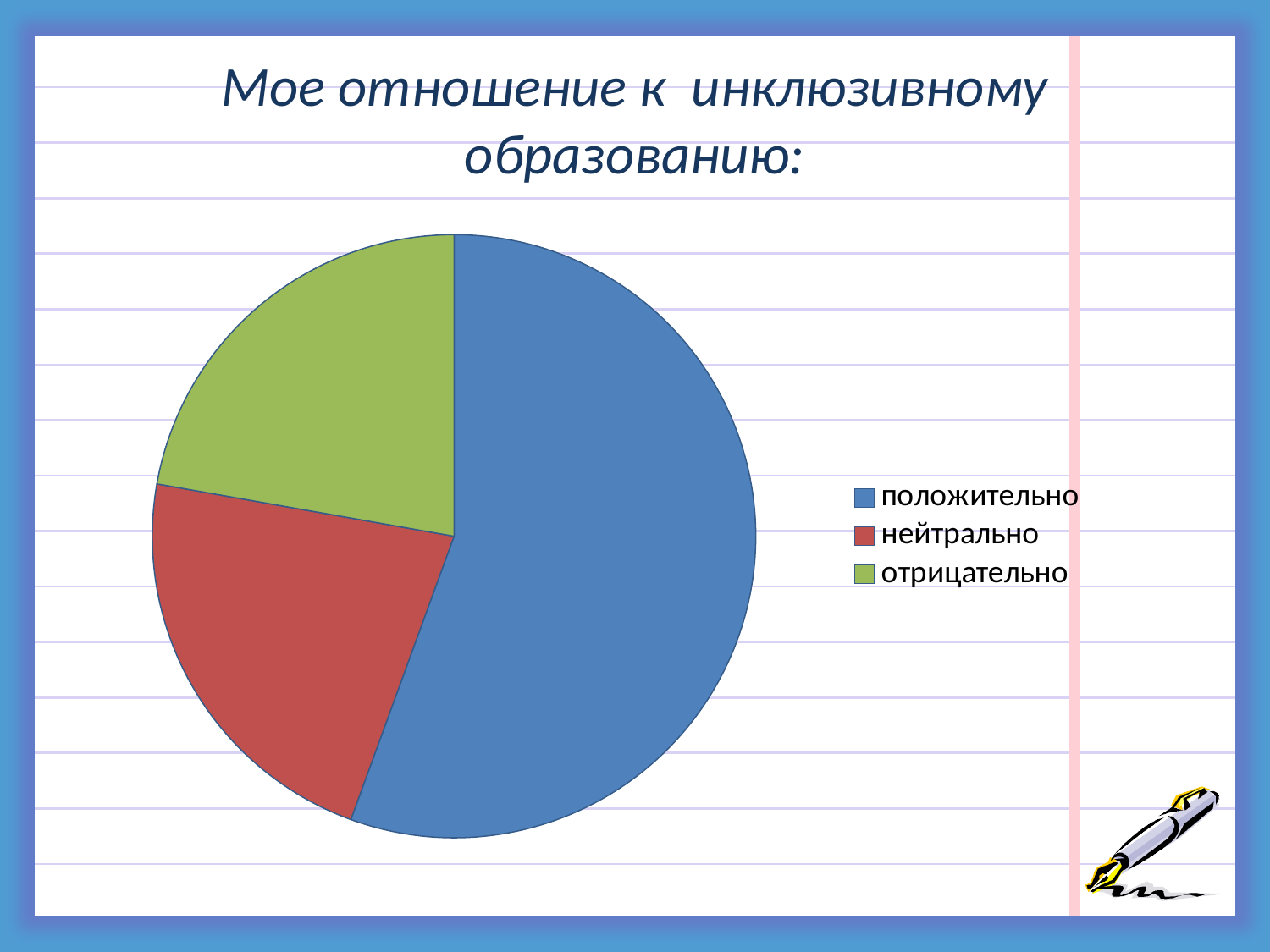
Which colour represents the нейтрально category in the pie chart? red How many entries does the legend of the pie chart list? 3 Which slice is larger, отрицательно or положительно? положительно How many slices does the pie chart have? 3 What kind of chart is shown on the slide? pie chart Does the положительно slice take up more or less than half of the pie chart? more What is the title of the chart on the slide? Мое отношение к инклюзивному образованию: Which category has the largest slice of the pie chart? положительно Which slice is larger, положительно or нейтрально? положительно